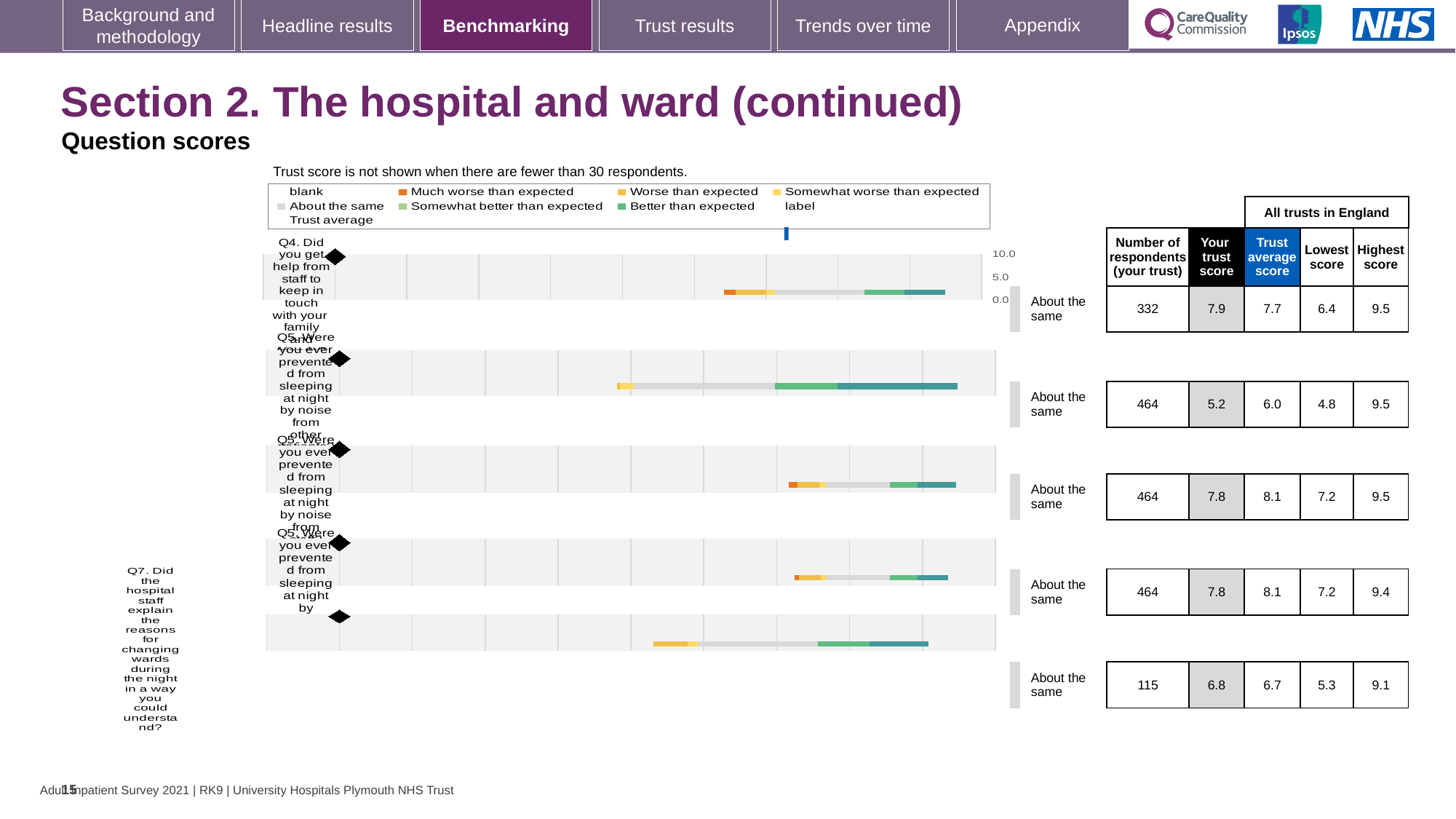
How many respondents are shown for the last row (Q7)? 115 What is the 'Highest score' for the last row (Q7, explaining reasons for changing wards during the night)? 9.1 How many question rows are plotted on the chart? 5 Which row has the lowest 'Your trust score' in the table? The second row (5.2) How many respondents from your trust are shown for the first row (Q4, help from staff to keep in touch with family and friends)? 332 What is the difference between 'Your trust score' and 'Trust average score' for the first row (Q4)? 0.2 What is the 'Lowest score' for the last row (Q7)? 5.3 What benchmark category label is shown next to every row of the chart? About the same What is the 'Trust average score' for the first row (Q4)? 7.7 What kind of chart is used to show the question scores? Bar chart What is 'Your trust score' for the first row (Q4) in the table? 7.9 For the second row, which is larger: 'Your trust score' or 'Trust average score'? Trust average score (6.0)